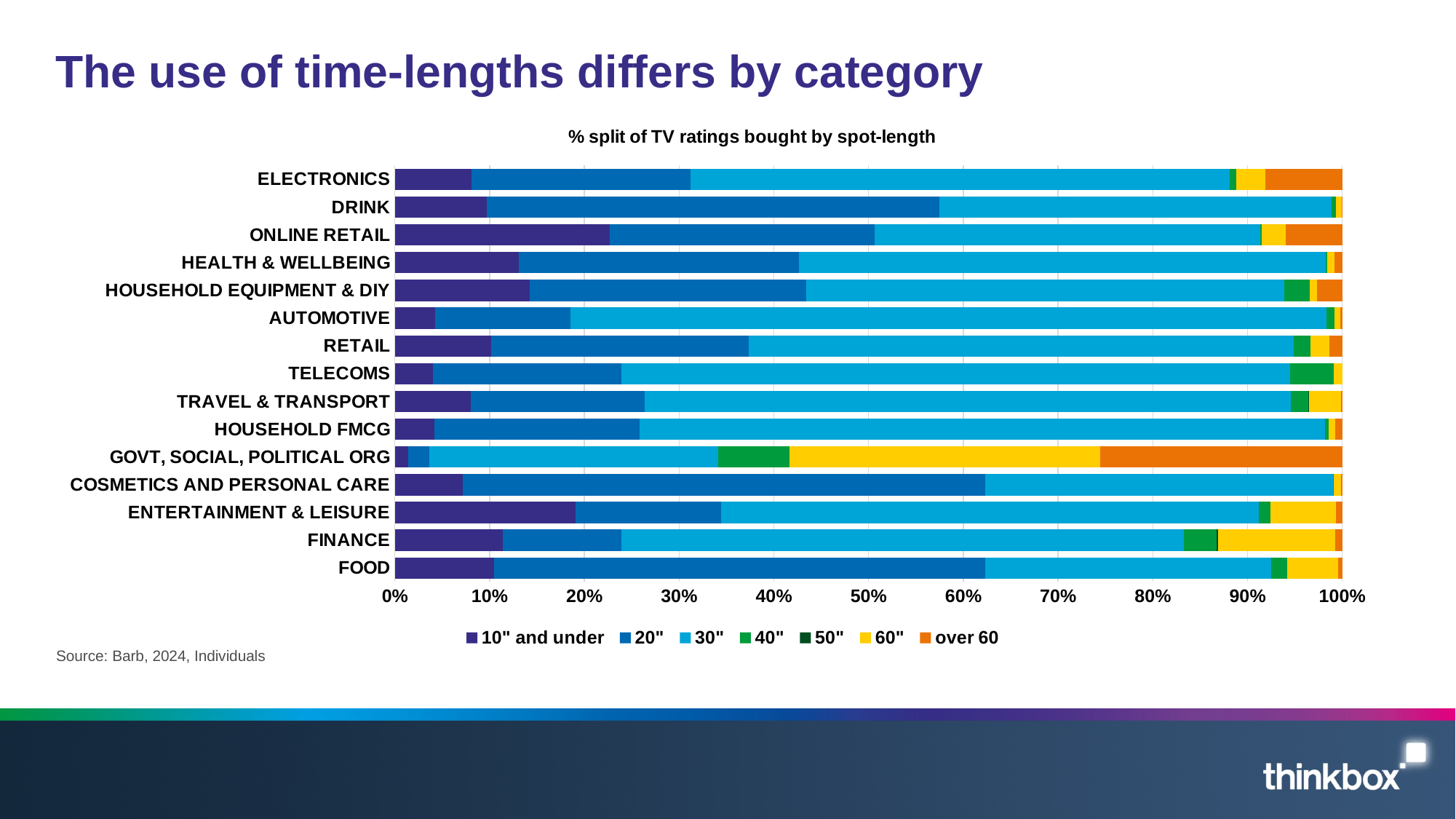
Is the '10" and under' share for ONLINE RETAIL greater or less than 20%? greater Which category has the largest 'over 60' share? GOVT, SOCIAL, POLITICAL ORG What is the title of the chart? % split of TV ratings bought by spot-length Which has the larger '30"' share, AUTOMOTIVE or FOOD? AUTOMOTIVE Which category has the largest '60"' share? GOVT, SOCIAL, POLITICAL ORG Which category has the largest '10" and under' share? ONLINE RETAIL Is the '10" and under' share for AUTOMOTIVE greater or less than 10%? less What kind of chart is shown on the slide? Stacked bar chart How many series does the legend list? 7 How many categories are plotted on the chart? 15 Which has the larger 'over 60' share, GOVT, SOCIAL, POLITICAL ORG or ELECTRONICS? GOVT, SOCIAL, POLITICAL ORG Which category has the smallest '10" and under' share? GOVT, SOCIAL, POLITICAL ORG